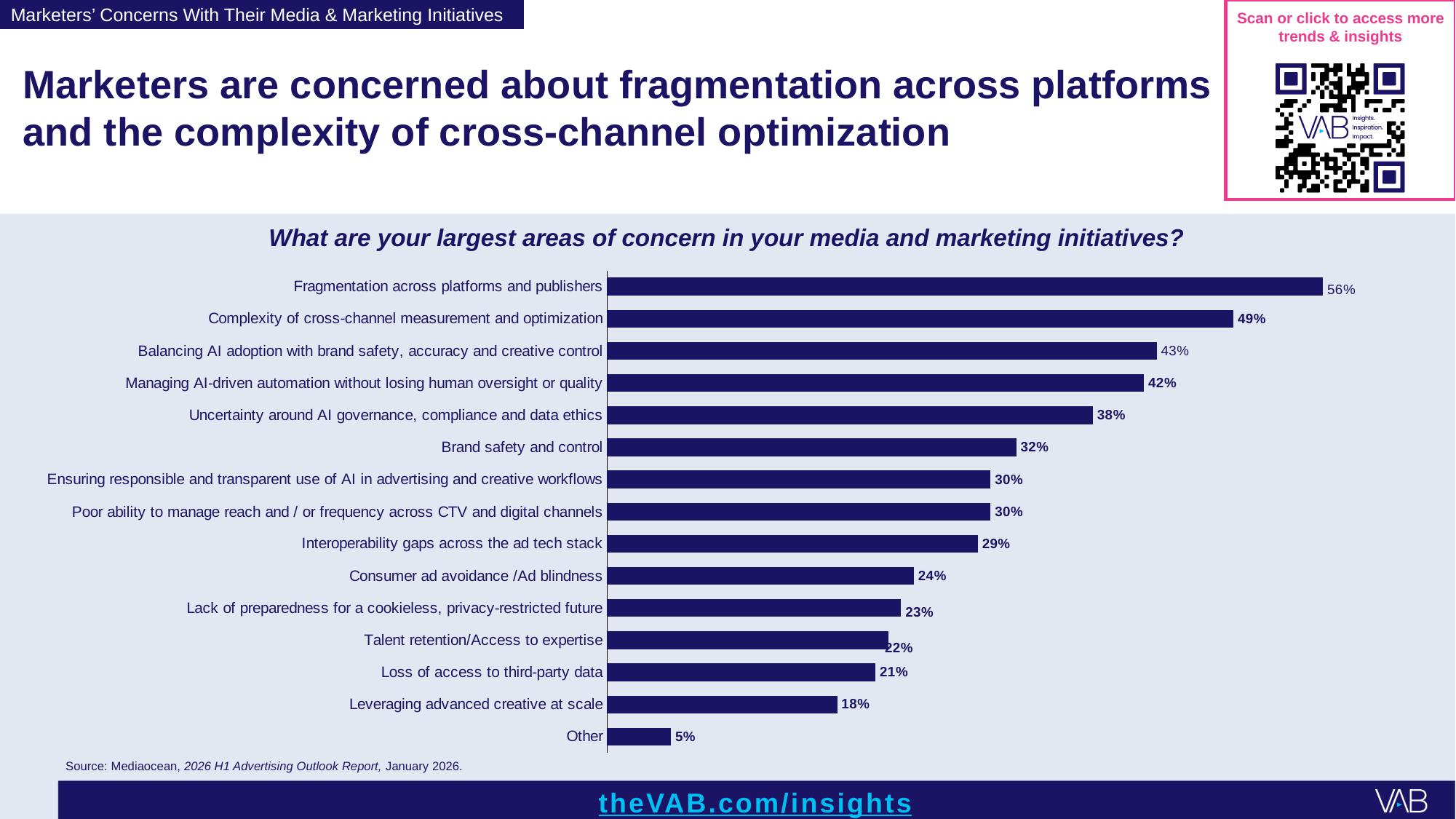
What type of chart is shown on the slide? Bar chart Which is larger: 'Consumer ad avoidance /Ad blindness' or 'Loss of access to third-party data'? Consumer ad avoidance /Ad blindness What question does the chart title ask? What are your largest areas of concern in your media and marketing initiatives? What percentage is shown for 'Leveraging advanced creative at scale'? 18% What percentage of marketers cited fragmentation across platforms and publishers as a concern? 56% What is the difference between 'Uncertainty around AI governance, compliance and data ethics' and 'Interoperability gaps across the ad tech stack'? 9% What is the value for 'Brand safety and control'? 32% Which category has the lowest percentage? Other Which area of concern has the highest percentage? Fragmentation across platforms and publishers What is the value for 'Poor ability to manage reach and / or frequency across CTV and digital channels'? 30% What is the difference between 'Fragmentation across platforms and publishers' and 'Complexity of cross-channel measurement and optimization'? 7% How many categories are shown in the chart? 15